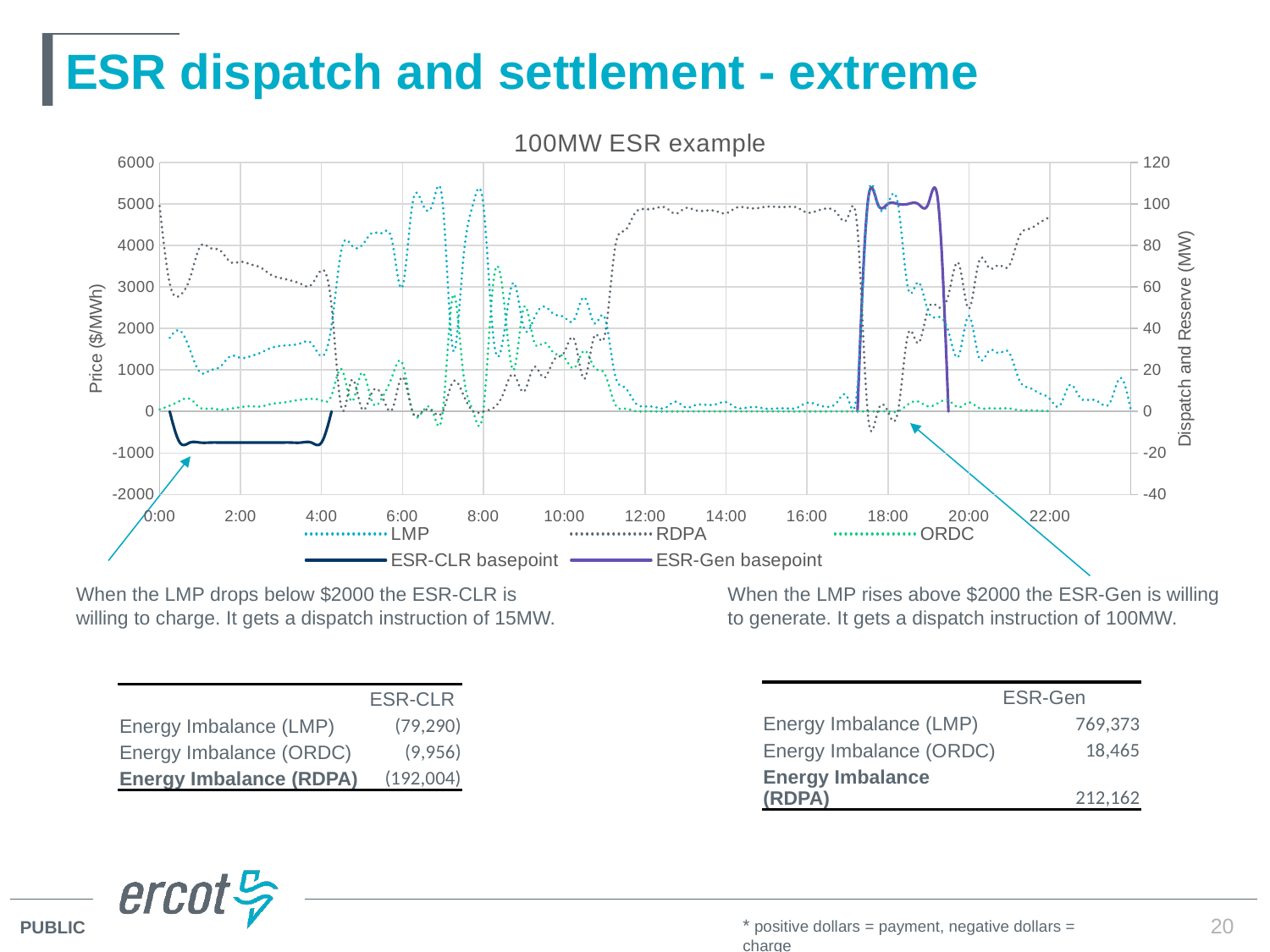
Is the value of the ESR-Gen basepoint at 18:00 greater or less than 80 on the right axis? greater How many series does the legend of the chart list? 5 Is the value of LMP at 13:00 greater or less than 1000 on the left axis? less Is the value of the ESR-CLR basepoint at 2:00 greater or less than 0 on the right axis? less What kind of chart is shown on the slide? line chart What is the label of the left vertical axis of the chart? Price ($/MWh) At 13:00, which is larger, the RDPA value or the LMP value? RDPA What is the title of the chart? 100MW ESR example